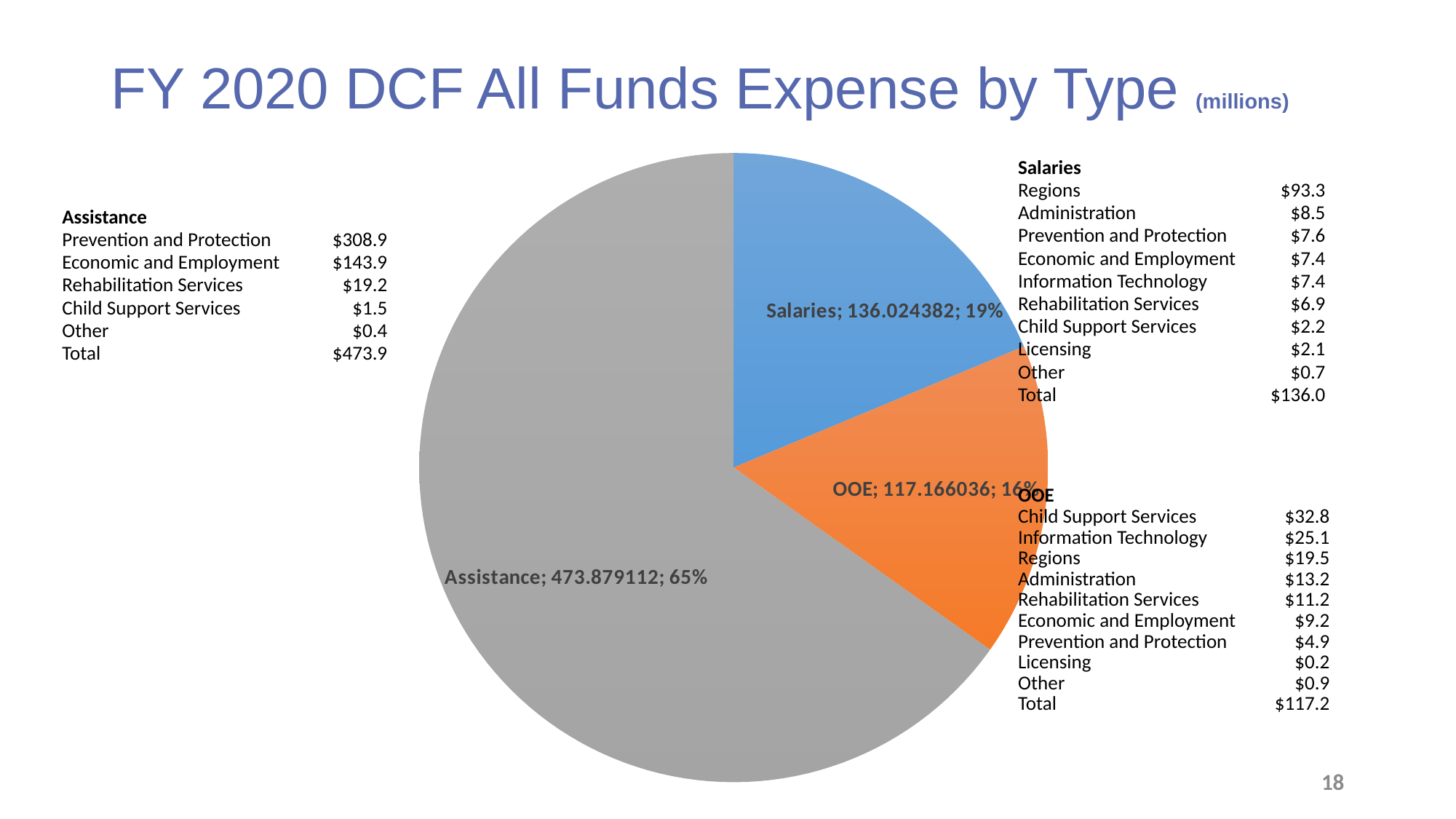
What value is printed on the OOE slice of the pie chart? 117.166036 What share of the pie does the OOE slice represent? 16% What share of the pie does the Salaries slice represent? 19% What kind of chart is shown on the slide? pie chart How many slices does the pie chart have? 3 Which slice of the pie chart is the smallest? OOE Which slice of the pie chart is the largest? Assistance What value is printed on the Salaries slice of the pie chart? 136.024382 Which is larger in the pie chart, Salaries or OOE? Salaries What value is printed on the Assistance slice of the pie chart? 473.879112 What colour is the Assistance slice of the pie chart? grey What share of the pie does the Assistance slice represent? 65%